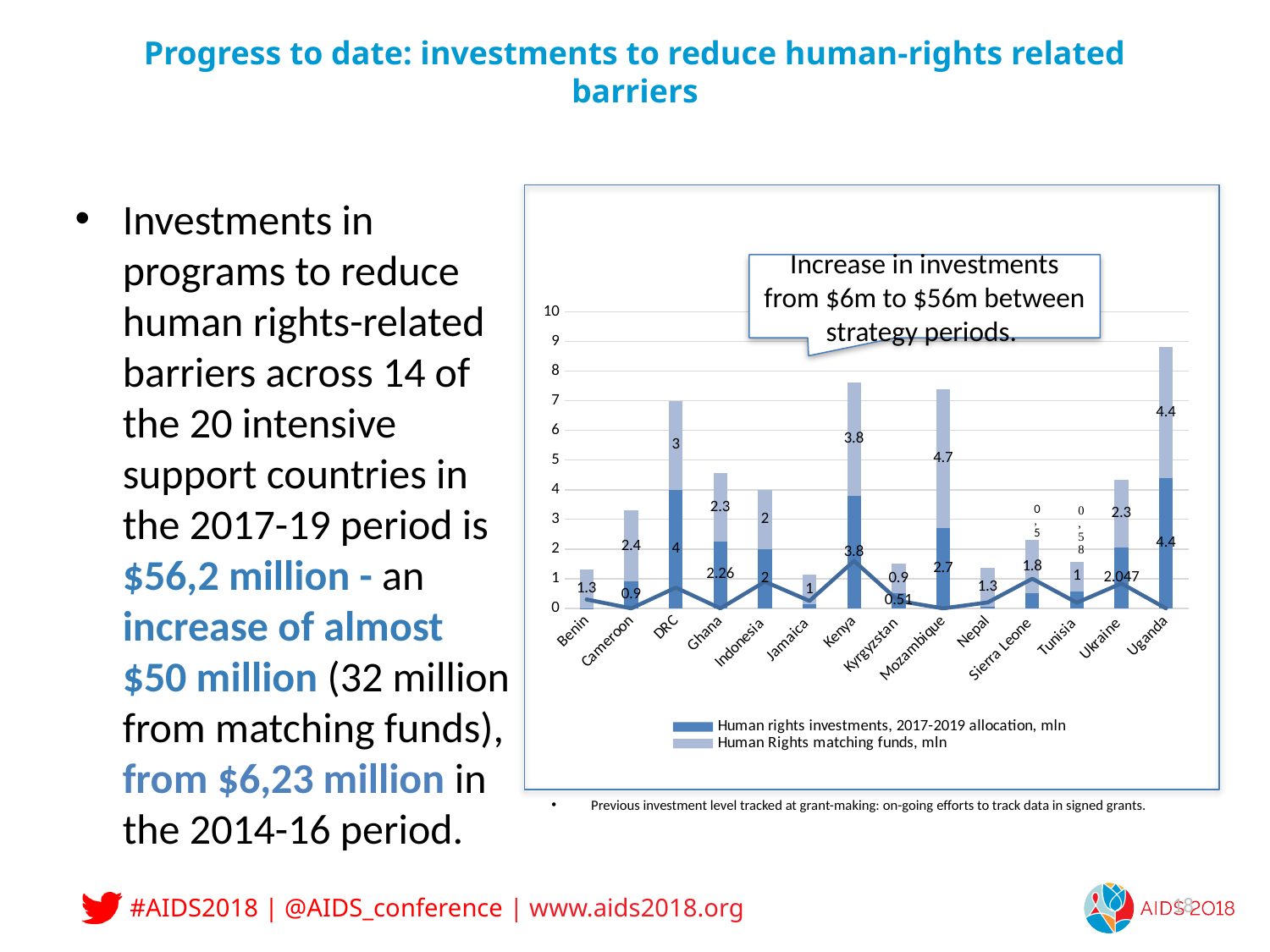
What kind of chart is shown on the slide? Combination stacked bar and line chart What is the value of Human Rights matching funds for DRC? 3 What is the value of Human Rights matching funds for Mozambique? 4.7 What is the total of the stacked bar for DRC (allocation plus matching funds)? 7 What is the Human rights investments 2017-2019 allocation for Kenya? 3.8 How many series does the chart legend list? 2 According to the callout on the chart, investments increased from what amount to what amount between strategy periods? From $6m to $56m How many countries are shown on the x axis of the chart? 14 What is the Human rights investments 2017-2019 allocation for Uganda? 4.4 What is the difference between the matching funds for Mozambique and for DRC? 1.7 Which country has the tallest stacked bar in the chart? Uganda Is the total stacked bar for Uganda greater or less than 8? greater